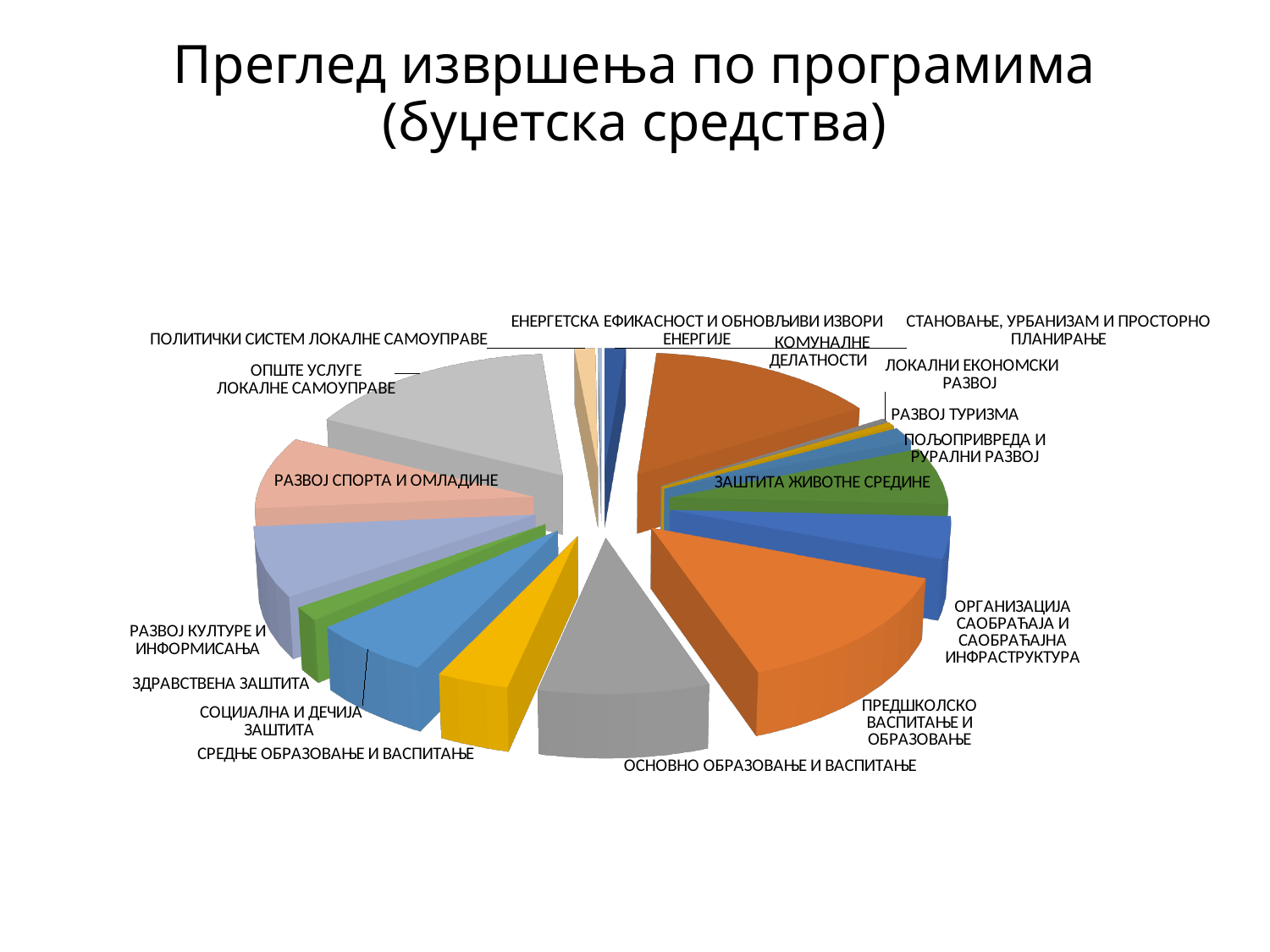
Which slice is larger: СРЕДЊЕ ОБРАЗОВАЊЕ И ВАСПИТАЊЕ or ПОЉОПРИВРЕДА И РУРАЛНИ РАЗВОЈ? СРЕДЊЕ ОБРАЗОВАЊЕ И ВАСПИТАЊЕ How many program categories (slices) does the pie chart show? 17 What is the title of the chart on the slide? Преглед извршења по програмима (буџетска средства) Which slice is larger: ОПШТЕ УСЛУГЕ ЛОКАЛНЕ САМОУПРАВЕ or ЕНЕРГЕТСКА ЕФИКАСНОСТ И ОБНОВЉИВИ ИЗВОРИ ЕНЕРГИЈЕ? ОПШТЕ УСЛУГЕ ЛОКАЛНЕ САМОУПРАВЕ Which slice is larger: РАЗВОЈ СПОРТА И ОМЛАДИНЕ or ЛОКАЛНИ ЕКОНОМСКИ РАЗВОЈ? РАЗВОЈ СПОРТА И ОМЛАДИНЕ What colour is the slice for ЗАШТИТА ЖИВОТНЕ СРЕДИНЕ? green What kind of chart is shown on the slide? pie chart